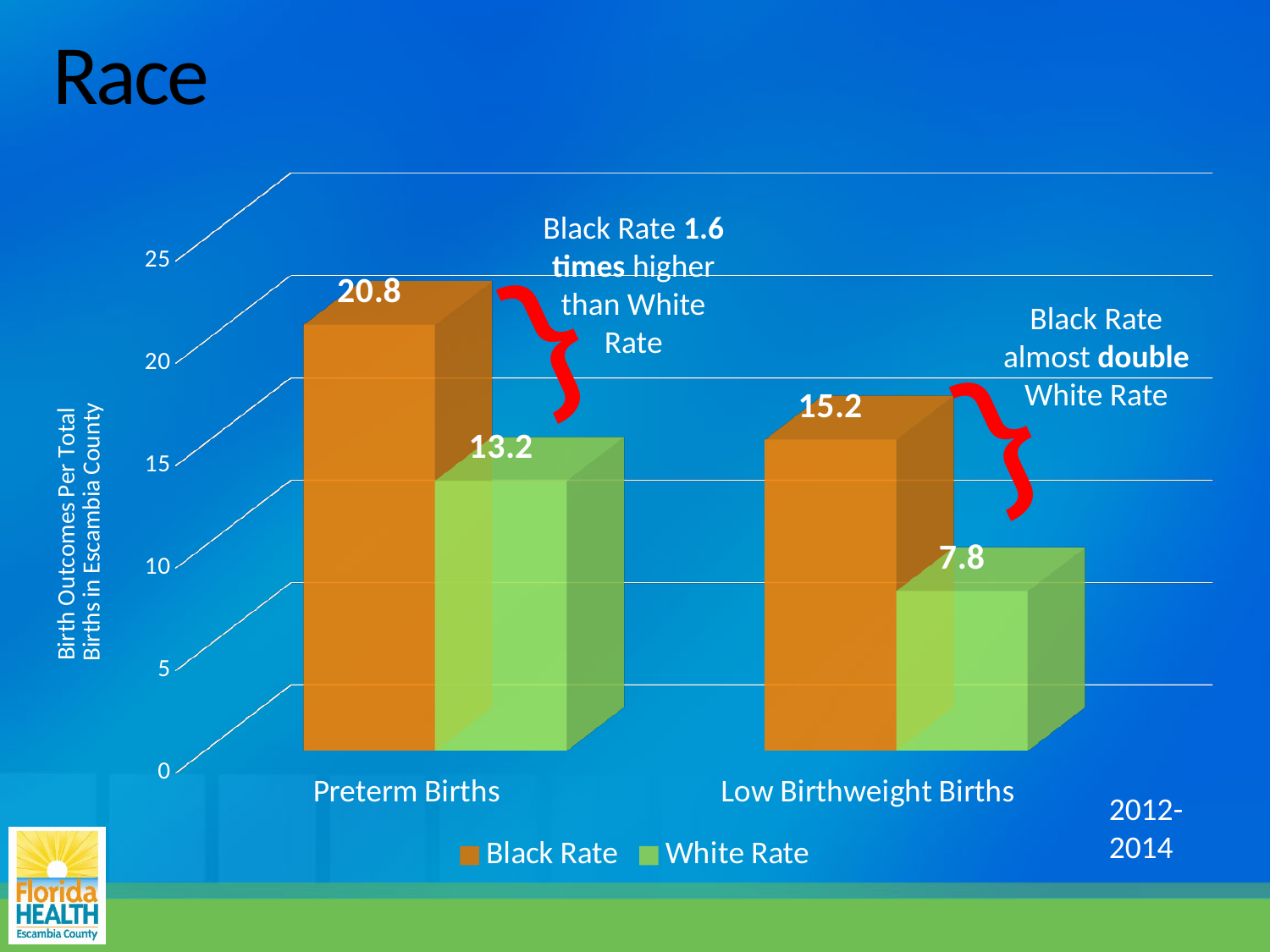
Which is larger for Low Birthweight Births, the Black Rate or the White Rate? Black Rate What is the difference between the Black Rate and the White Rate for Preterm Births? 7.6 Which category has the highest Black Rate? Preterm Births Which category has the lowest White Rate? Low Birthweight Births What is the White Rate for Preterm Births? 13.2 What is the White Rate for Low Birthweight Births? 7.8 How many series does the legend list? 2 What kind of chart is shown on the slide? Bar chart What is the Black Rate for Preterm Births? 20.8 What is the difference between the Black Rate and the White Rate for Low Birthweight Births? 7.4 How many categories are shown on the x axis? 2 What is the Black Rate for Low Birthweight Births? 15.2